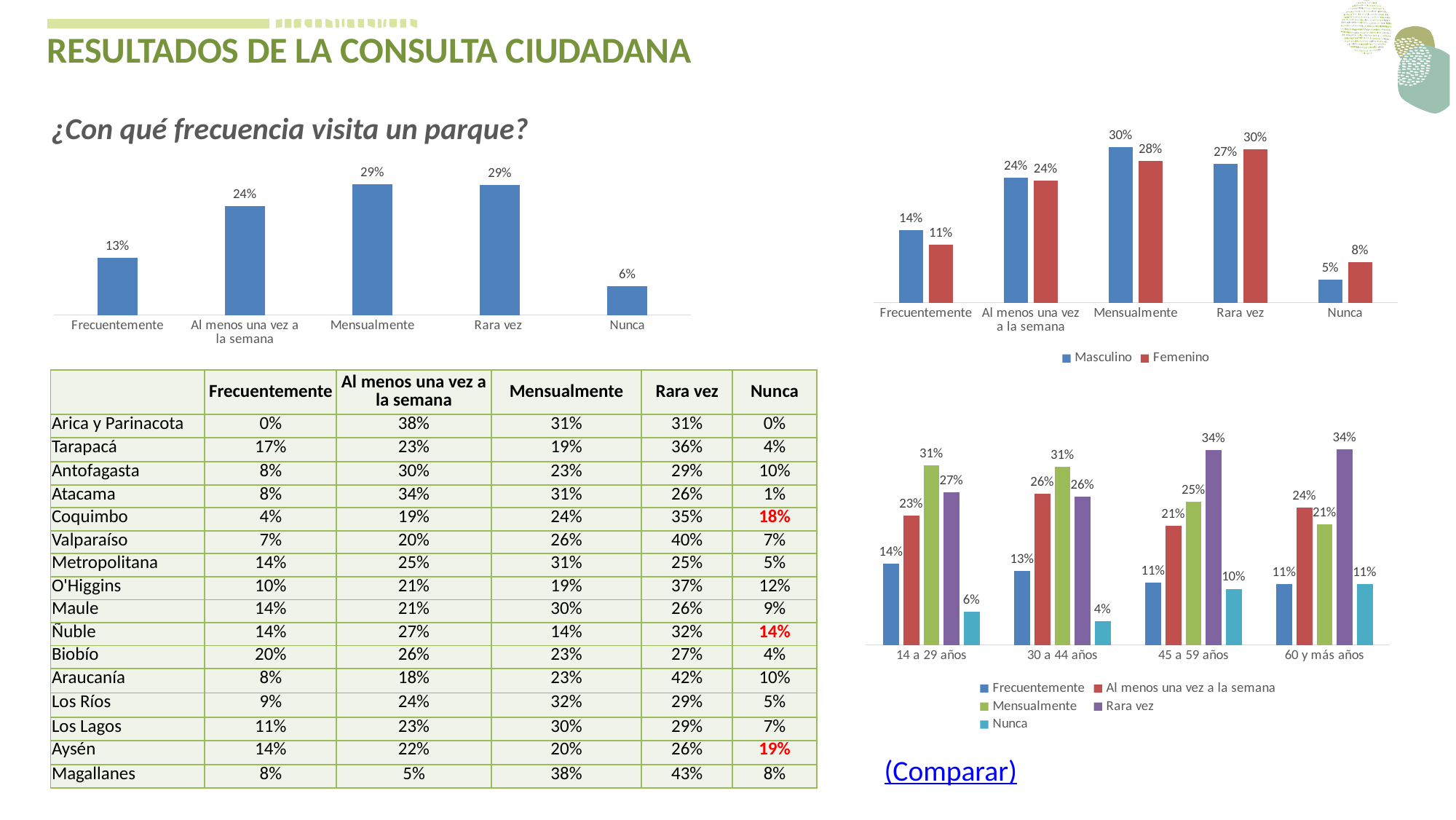
In the top-left chart, what is the value for Nunca? 6% In the top-right chart (Masculino/Femenino), how many series does the legend list? 2 In the bottom-right chart by age group, what is the Rara vez value for 45 a 59 años? 34% In the top-right chart (Masculino/Femenino), which is larger for Frecuentemente, Masculino or Femenino? Masculino In the top-right chart (Masculino/Femenino), what is the Femenino value for Rara vez? 30% In the top-left chart, how many categories are shown on the x axis? 5 In the bottom-right chart by age group, which category has the highest value for 14 a 29 años? Mensualmente In the top-left chart, what is the difference between Al menos una vez a la semana and Frecuentemente? 11% What kind of chart is the bottom-right chart by age group? Bar chart In the bottom-right chart by age group, what is the Nunca value for 30 a 44 años? 4% In the top-right chart (Masculino/Femenino), what is the Masculino value for Mensualmente? 30% In the top-left chart, which category has the lowest value? Nunca